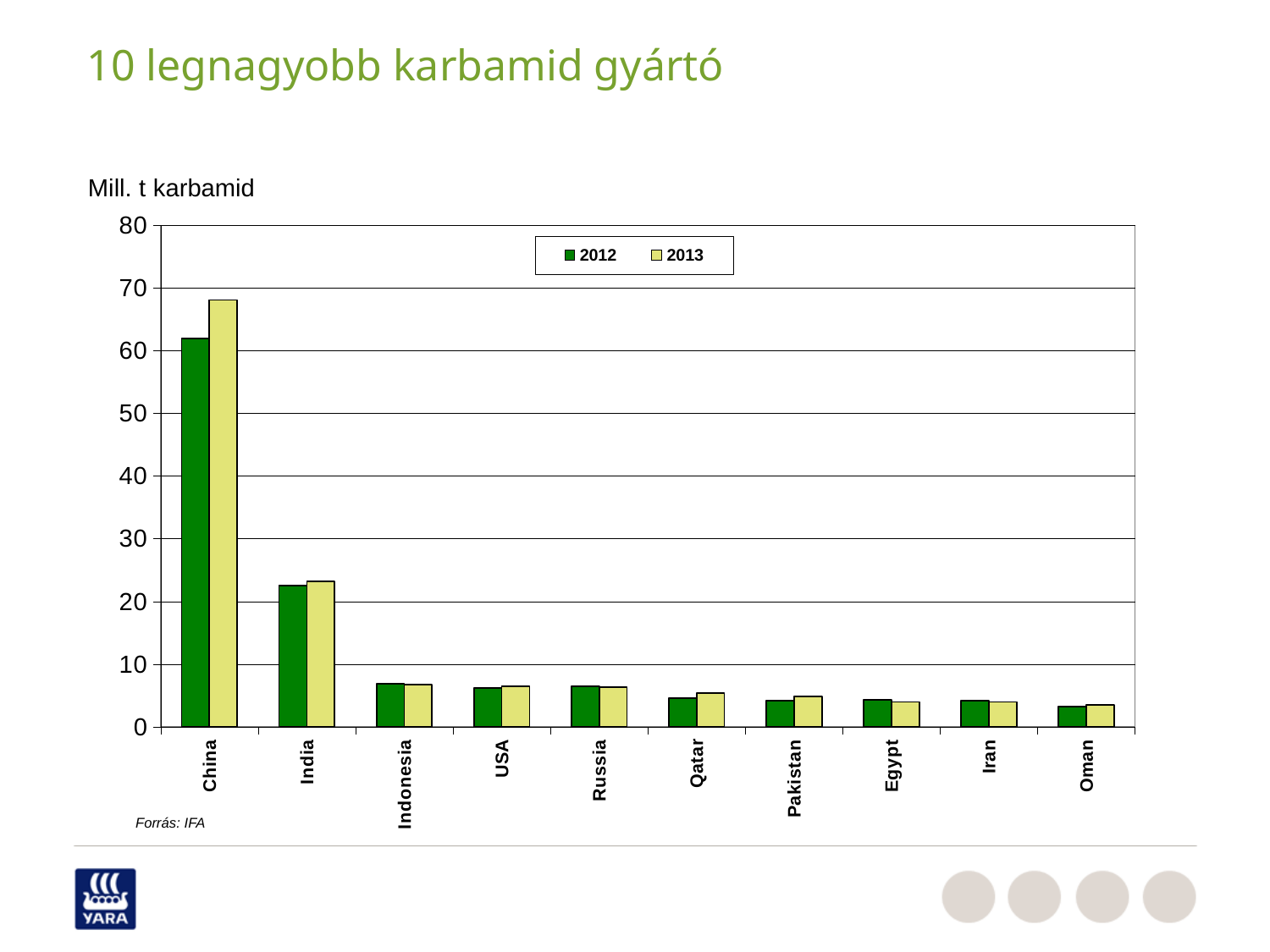
How many series does the chart's legend list? 2 Is the 2013 value for China greater or less than 70? less What kind of chart is shown on the slide? bar chart What unit label is shown above the chart's y axis? Mill. t karbamid Is the 2013 value for Indonesia greater or less than 10? less Which country has the lowest urea production in the chart? Oman What are the two series listed in the chart's legend? 2012 and 2013 How many countries are shown on the x axis of the chart? 10 For China, which year has the larger value, 2012 or 2013? 2013 Which country has the highest urea production in the chart? China Is the 2012 value for China greater or less than 60? greater